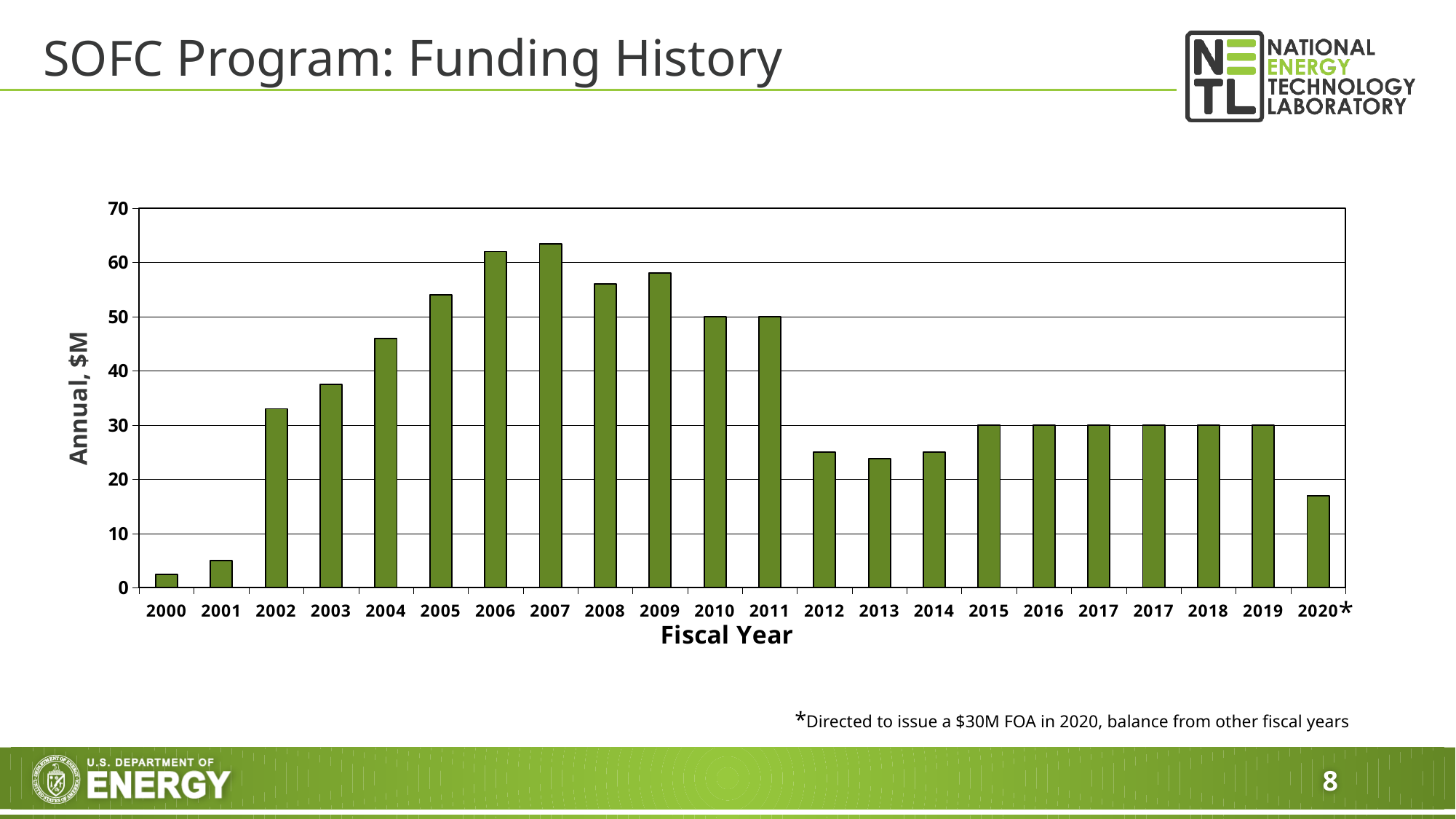
Is the value for 2020 greater or less than 20? less Which fiscal year has the highest value? 2007 What is the value for fiscal year 2016? 30 Is the value for 2004 greater or less than 40? greater What is the title of the vertical axis? Annual, $M Is the value for 2008 greater or less than 50? greater Do the values rise or fall from 2000 to 2007? Rise Which is larger, the value for 2003 or the value for 2002? 2003 Which fiscal year has the lowest value? 2000 What kind of chart is shown on the slide? Bar chart How many bars are plotted in the chart? 22 What is the value for fiscal year 2010? 50